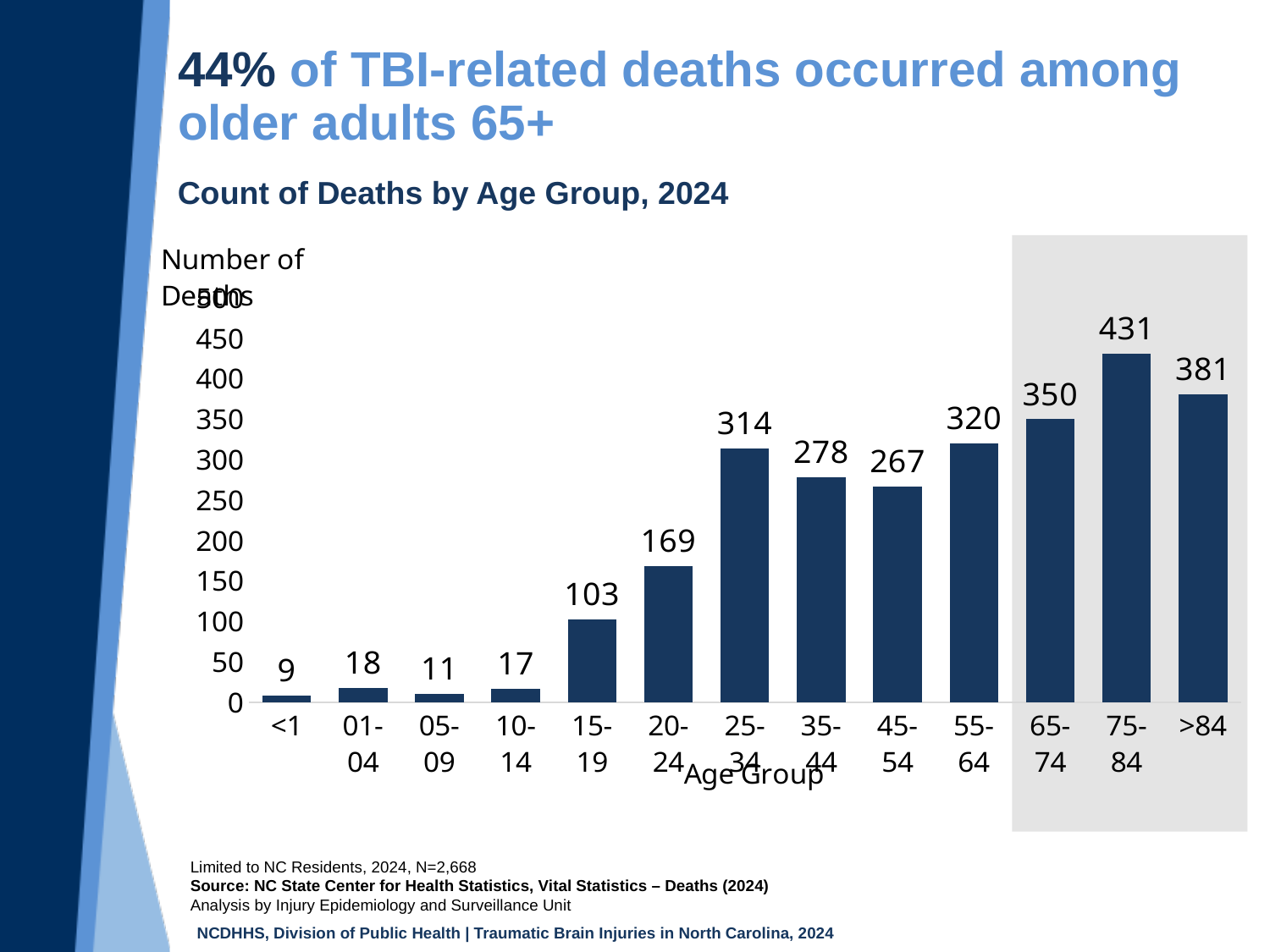
What is the difference in deaths between the 25-34 and 20-24 age groups? 145 Is the value for the 55-64 age group greater or less than 300? greater What is the count of deaths for the <1 age group? 9 What kind of chart is shown on the slide? Bar chart How many TBI-related deaths were there in the 75-84 age group? 431 Which age group has the lowest count of deaths? <1 Which age group has more deaths, 35-44 or 45-54? 35-44 Which age group has the highest count of deaths? 75-84 What is the difference in deaths between the 75-84 and >84 age groups? 50 How many age groups are shown on the x axis? 13 What is the total number of deaths across the 65-74, 75-84 and >84 age groups? 1,162 What is the count of deaths for the 15-19 age group? 103